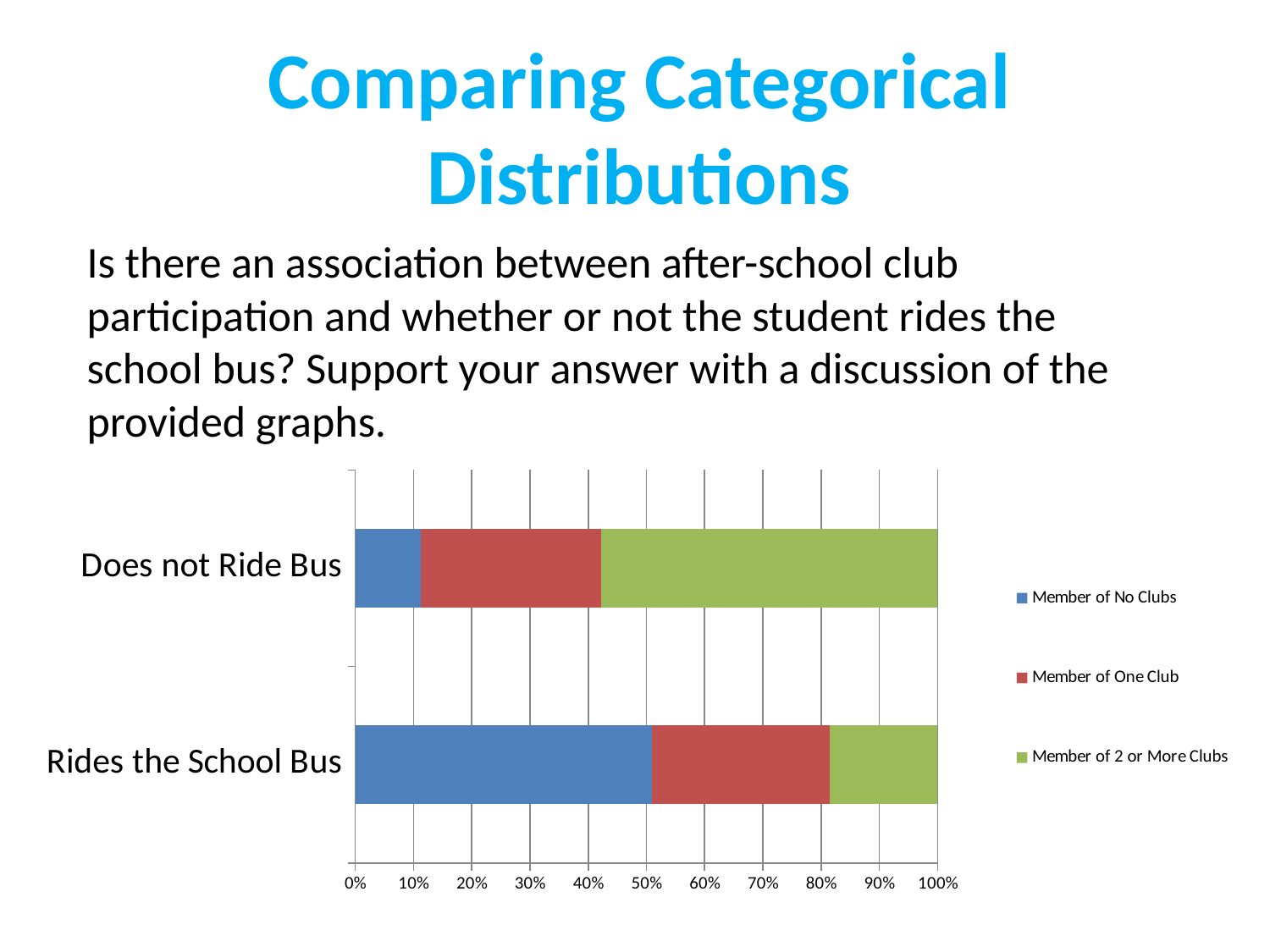
Which series makes up the smallest share of the "Rides the School Bus" bar? Member of 2 or More Clubs Which category has the larger "Member of No Clubs" share, "Rides the School Bus" or "Does not Ride Bus"? Rides the School Bus What kind of chart is shown on the slide? Stacked bar chart Is the "Member of No Clubs" share for "Rides the School Bus" greater or less than 40%? greater Which series makes up the largest share of the "Does not Ride Bus" bar? Member of 2 or More Clubs Which series makes up the largest share of the "Rides the School Bus" bar? Member of No Clubs Is the "Member of 2 or More Clubs" share for "Does not Ride Bus" greater or less than 50%? greater Which series makes up the smallest share of the "Does not Ride Bus" bar? Member of No Clubs How many categories are shown on the vertical axis of the chart? 2 What colour represents "Member of One Club" in the chart? Red Is the "Member of No Clubs" share for "Does not Ride Bus" greater or less than 20%? less How many series does the chart's legend list? 3